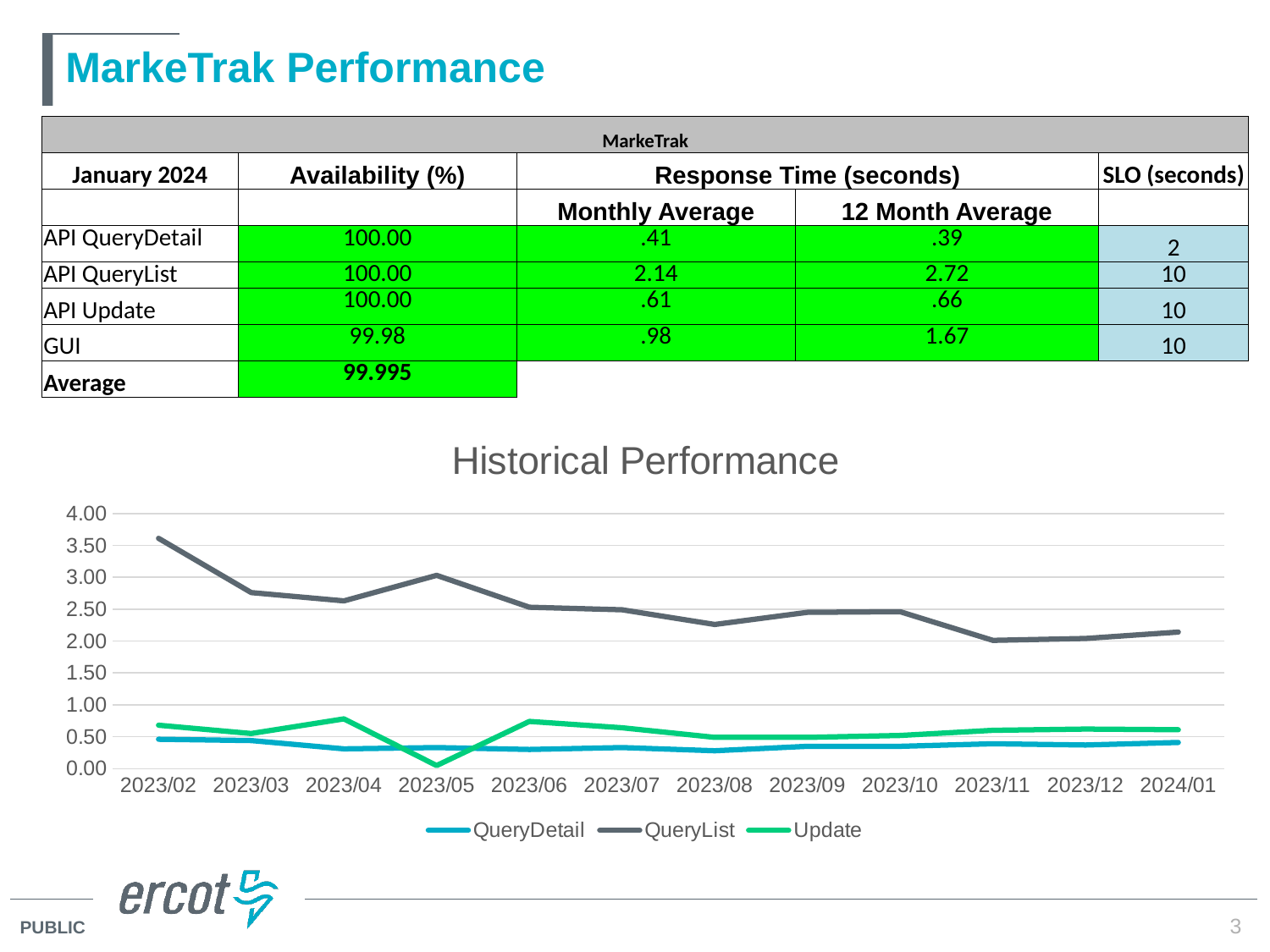
In the Historical Performance chart, is the QueryList value for 2024/01 greater or less than 2.50? less What is the title of the line chart on the slide? Historical Performance Which series in the Historical Performance chart has the highest values across all months? QueryList In the Historical Performance chart, is the QueryList value for 2023/02 greater or less than 3.00? greater In the Historical Performance chart, is the Update value for 2023/05 greater or less than 0.50? less In the Historical Performance chart, does the QueryList series generally rise or fall from 2023/02 to 2024/01? fall In the Historical Performance chart, at which month does the Update series reach its lowest value? 2023/05 What type of chart is the Historical Performance chart? line chart In the Historical Performance chart, which is larger at 2023/02: the QueryList value or the QueryDetail value? QueryList What is the first month shown on the x axis of the Historical Performance chart? 2023/02 How many months are shown on the x axis of the Historical Performance chart? 12 How many series does the legend of the Historical Performance chart list? 3